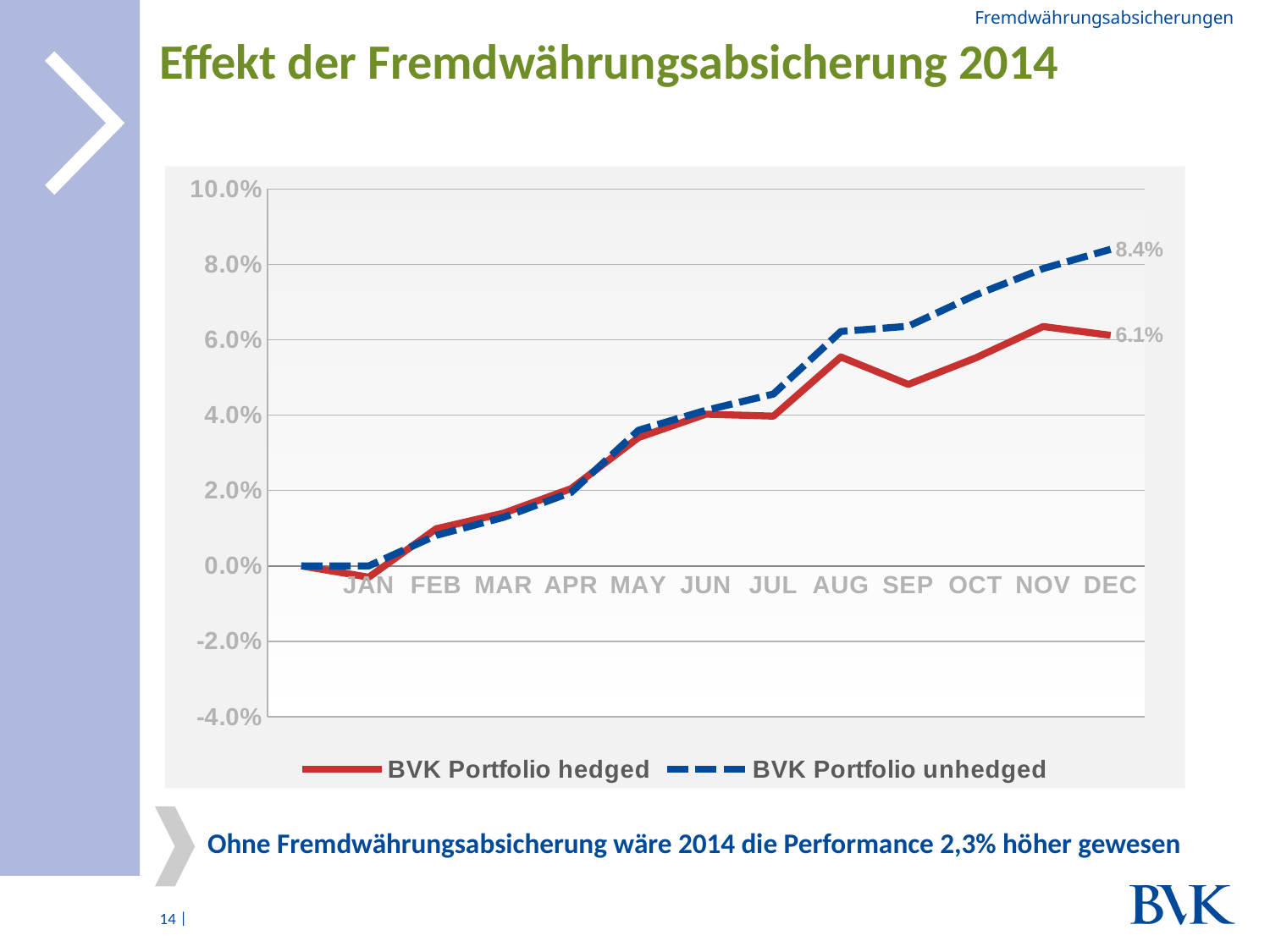
Which series has the higher value in DEC, BVK Portfolio hedged or BVK Portfolio unhedged? BVK Portfolio unhedged What is the difference between the DEC values of BVK Portfolio unhedged and BVK Portfolio hedged? 2.3% Do the values of BVK Portfolio unhedged generally rise or fall from JAN to DEC? rise How many months are shown on the x axis of the chart? 12 Is the value for BVK Portfolio unhedged in JUL greater or less than 6.0%? less What is the value of BVK Portfolio hedged in DEC? 6.1% What type of chart is shown on the slide? line chart Is the value for BVK Portfolio hedged in AUG greater or less than 4.0%? greater What is the value of BVK Portfolio unhedged in DEC? 8.4% Which series is drawn with a dashed line? BVK Portfolio unhedged What is the title of the chart slide? Effekt der Fremdwährungsabsicherung 2014 How many series does the chart legend list? 2